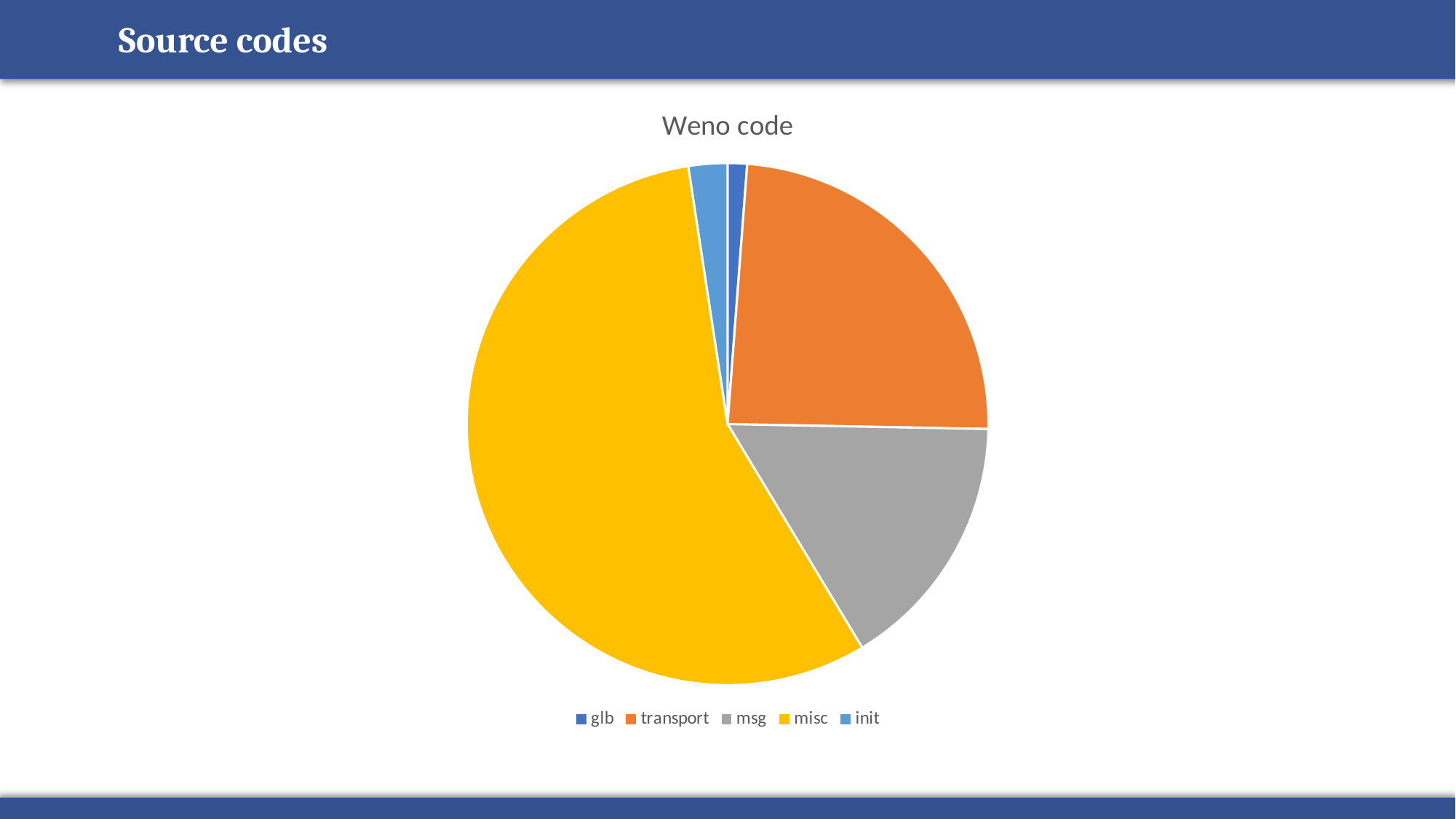
Which slice is larger, init or glb? init What is the title of the chart? Weno code How many categories does the pie chart have? 5 Which category has the largest slice of the pie? misc Which slice is larger, transport or msg? transport Which slice is larger, msg or init? msg What kind of chart is shown on the slide? pie chart Which category has the smallest slice of the pie? glb Which category is shown in yellow in the pie chart? misc